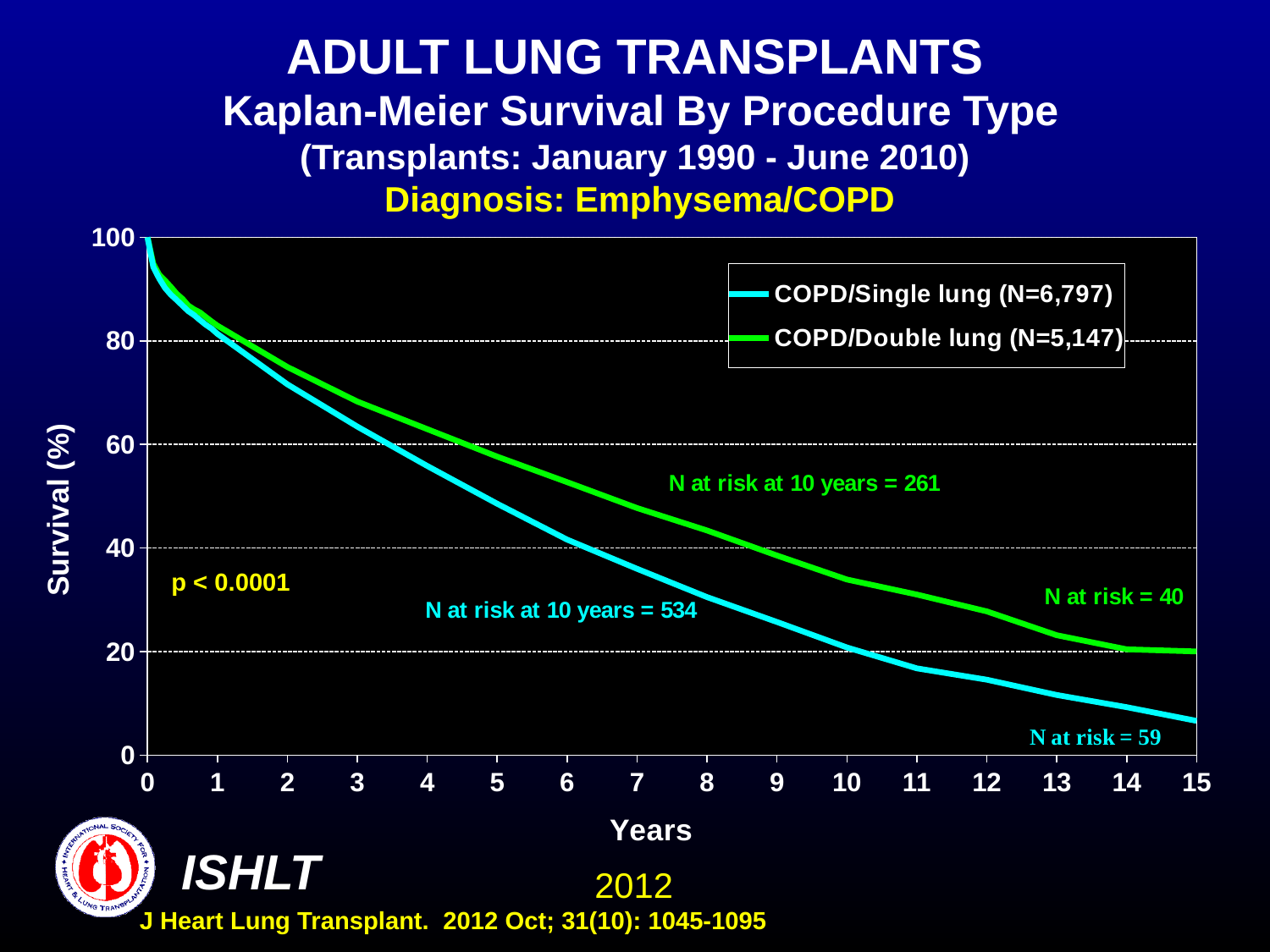
Is the survival for COPD/Double lung at 10 years greater or less than 40%? less What is the N at risk at 10 years for the COPD/Single lung group? 534 What is the number of patients (N) in the COPD/Single lung group? 6,797 Do the survival curves rise or fall as years increase? fall What is the N at risk at 10 years for the COPD/Double lung group? 261 Which group has higher survival at 10 years, COPD/Single lung or COPD/Double lung? COPD/Double lung What p-value is shown on the chart? p < 0.0001 Is the survival for COPD/Single lung at 15 years greater or less than 20%? less What kind of chart is shown on the slide? line chart How many series does the legend list? 2 What colour is the COPD/Single lung line? cyan What is the number of patients (N) in the COPD/Double lung group? 5,147